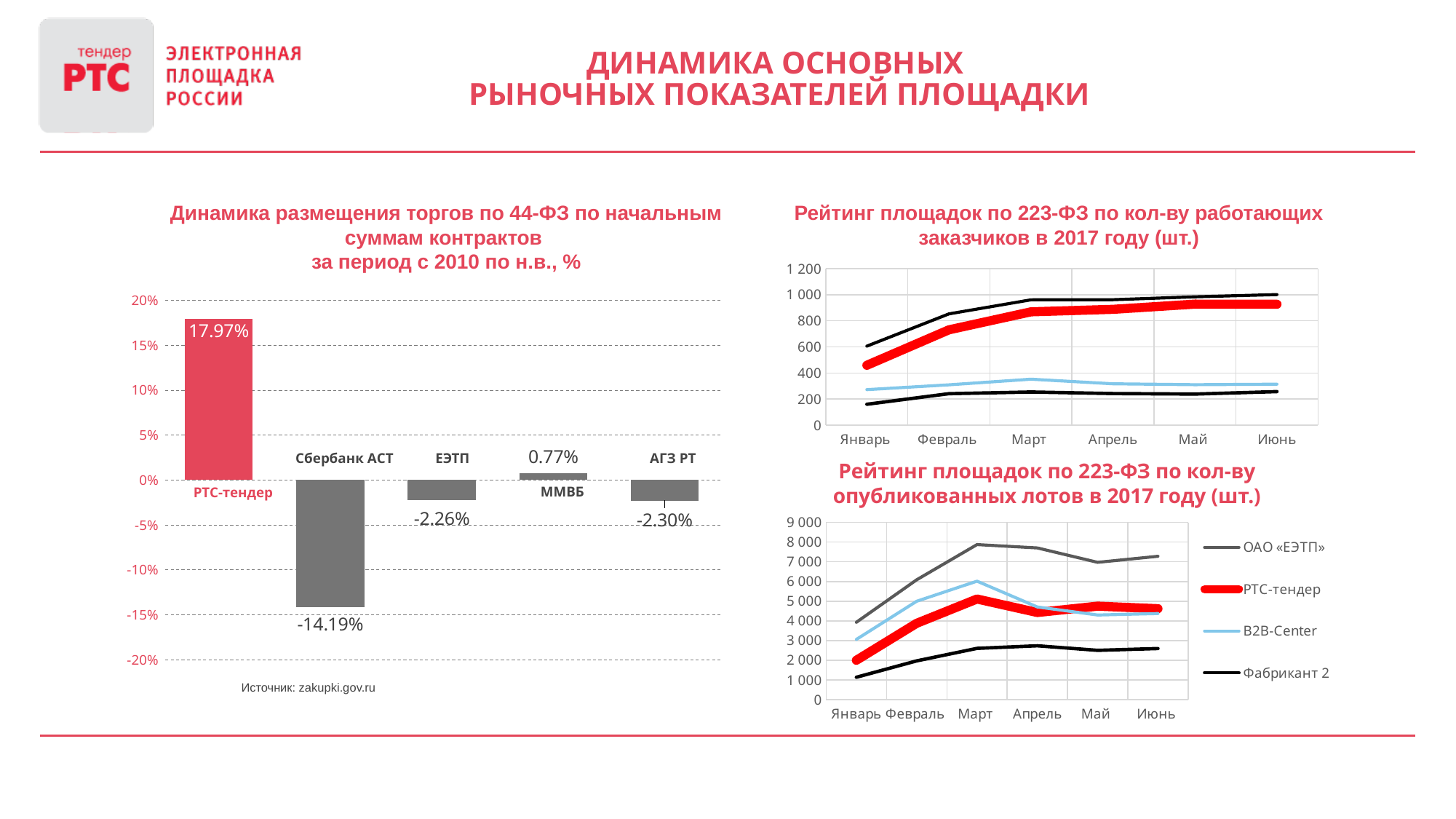
In the bar chart 'Динамика размещения торгов по 44-ФЗ', what is the difference between the values for РТС-тендер and Сбербанк АСТ? 32.16 percentage points In the bar chart 'Динамика размещения торгов по 44-ФЗ', what is the value for ММВБ? 0.77% How many series does the legend list in the bottom-right chart 'Рейтинг площадок по 223-ФЗ по кол-ву опубликованных лотов в 2017 году'? 4 In the bar chart 'Динамика размещения торгов по 44-ФЗ', which category has the highest value? РТС-тендер In the bottom-right chart 'Рейтинг площадок по 223-ФЗ по кол-ву опубликованных лотов в 2017 году', is the value for ОАО «ЕЭТП» in Март greater or less than 7 000? greater In the bar chart 'Динамика размещения торгов по 44-ФЗ', what is the value for Сбербанк АСТ? -14.19% How many categories are shown in the bar chart 'Динамика размещения торгов по 44-ФЗ'? 5 What kind of chart is the chart on the left of the slide, 'Динамика размещения торгов по 44-ФЗ'? Bar chart In the bar chart 'Динамика размещения торгов по 44-ФЗ', what is the value for РТС-тендер? 17.97% In the bar chart 'Динамика размещения торгов по 44-ФЗ', which is larger, the value for ММВБ or the value for ЕЭТП? ММВБ In the bar chart 'Динамика размещения торгов по 44-ФЗ', which category has the lowest value? Сбербанк АСТ In the bottom-right chart 'Рейтинг площадок по 223-ФЗ по кол-ву опубликованных лотов в 2017 году', does the Фабрикант 2 line rise or fall from Январь to Март? rise